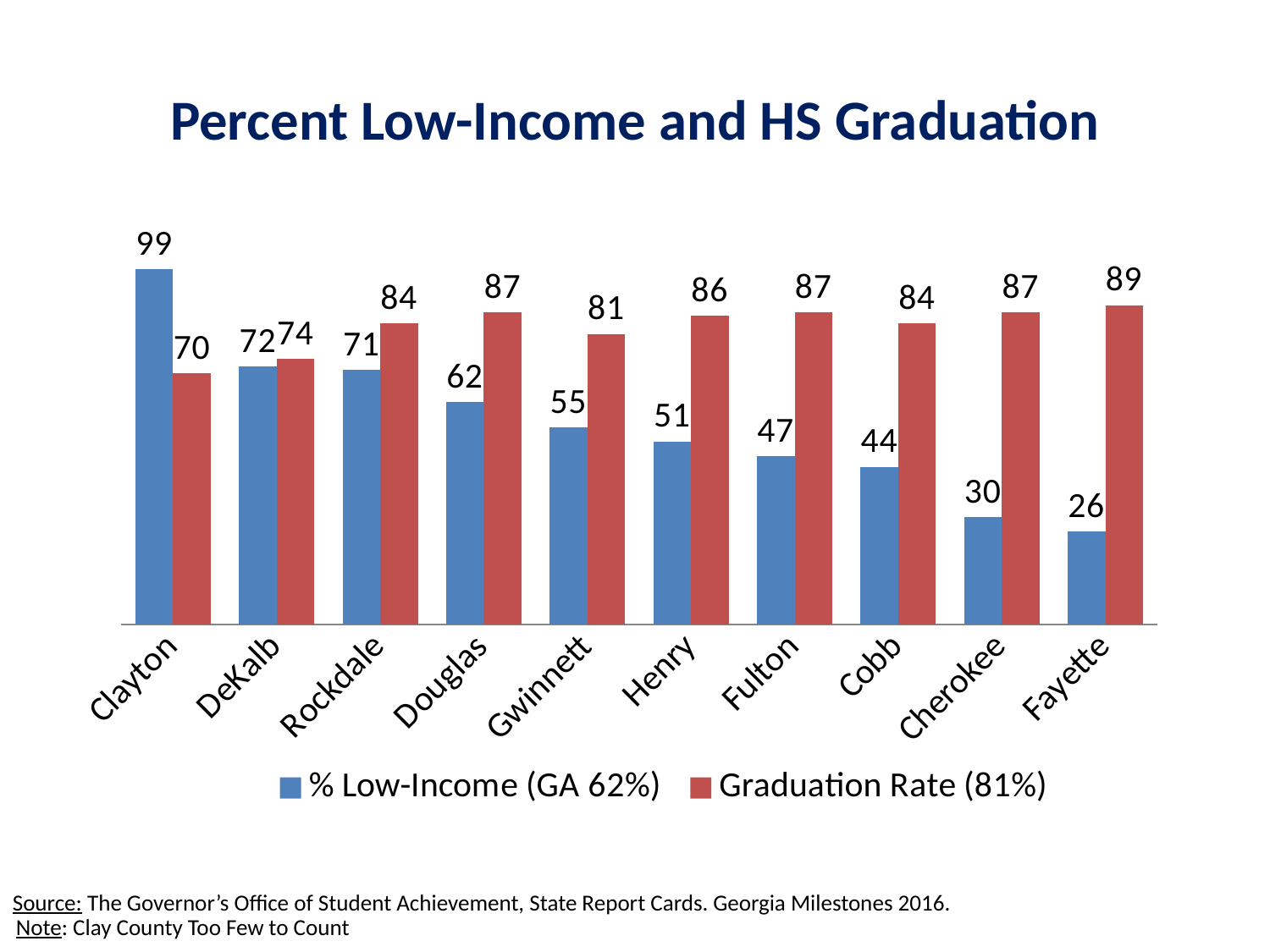
What is the % Low-Income value for Clayton? 99 Which county has the highest Graduation Rate? Fayette Which county has the lowest % Low-Income value? Fayette Which county has the lowest Graduation Rate? Clayton What is the difference between the Graduation Rate and the % Low-Income value for Fayette? 63 What is the % Low-Income value for Cherokee? 30 How many counties are shown on the x axis? 10 Do the % Low-Income values rise or fall from Clayton to Fayette along the x axis? fall What is the difference between the % Low-Income values for Clayton and DeKalb? 27 What is the Graduation Rate for Gwinnett? 81 How many series does the legend list? 2 Which is larger for Clayton: the % Low-Income value or the Graduation Rate? % Low-Income